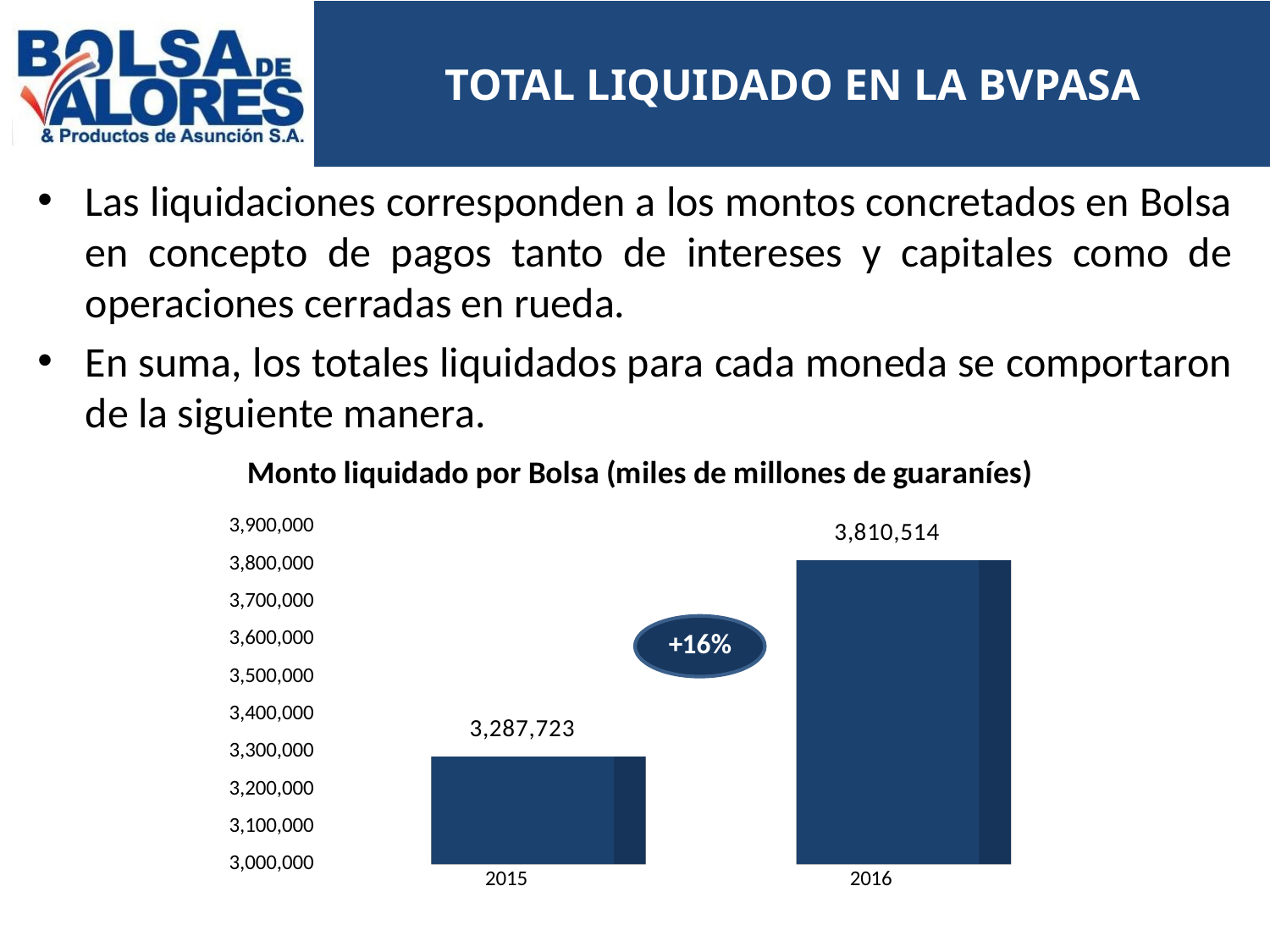
How many years are shown on the chart? 2 What is the value for 2016? 3,810,514 Which is larger, the value for 2015 or the value for 2016? 2016 What kind of chart is shown? bar chart Is the value for 2015 greater or less than 3,400,000? less Which year has the lowest value? 2015 Do the values rise or fall from 2015 to 2016? rise Which year has the highest value? 2016 What percentage change is shown in the oval between the two bars? +16% What is the value for 2015? 3,287,723 Is the value for 2016 greater or less than 3,700,000? greater What is the difference between the values for 2016 and 2015? 522,791